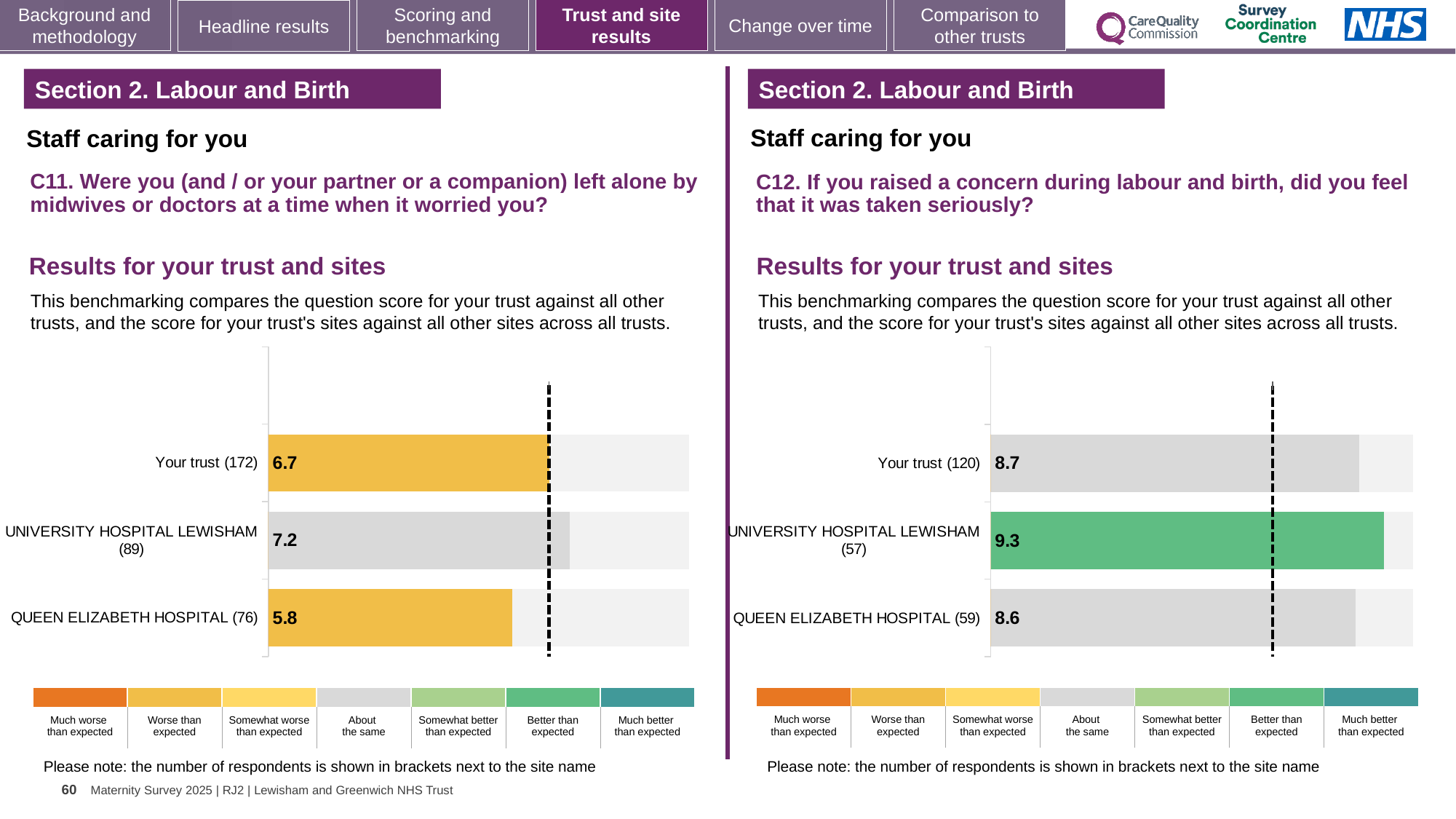
On the C11 chart (left), what is the score for UNIVERSITY HOSPITAL LEWISHAM (89)? 7.2 On the C12 chart (right), what is the score for QUEEN ELIZABETH HOSPITAL (59)? 8.6 On the C12 chart (right), what is the score for UNIVERSITY HOSPITAL LEWISHAM (57)? 9.3 How many bars are plotted on the C11 chart (left)? 3 On the C12 chart (right), which has the larger score: Your trust (120) or QUEEN ELIZABETH HOSPITAL (59)? Your trust (120) On the C11 chart (left), what is the score for Your trust (172)? 6.7 On the C11 chart (left), what is the difference between the scores for UNIVERSITY HOSPITAL LEWISHAM (89) and QUEEN ELIZABETH HOSPITAL (76)? 1.4 On the C12 chart (right), what is the score for Your trust (120)? 8.7 On the C11 chart (left), which site or trust has the lowest score? QUEEN ELIZABETH HOSPITAL (76) On the C11 chart (left), what is the score for QUEEN ELIZABETH HOSPITAL (76)? 5.8 On the C12 chart (right), which site or trust has the highest score? UNIVERSITY HOSPITAL LEWISHAM (57) What type of chart is used on the C12 chart (right)? Bar chart